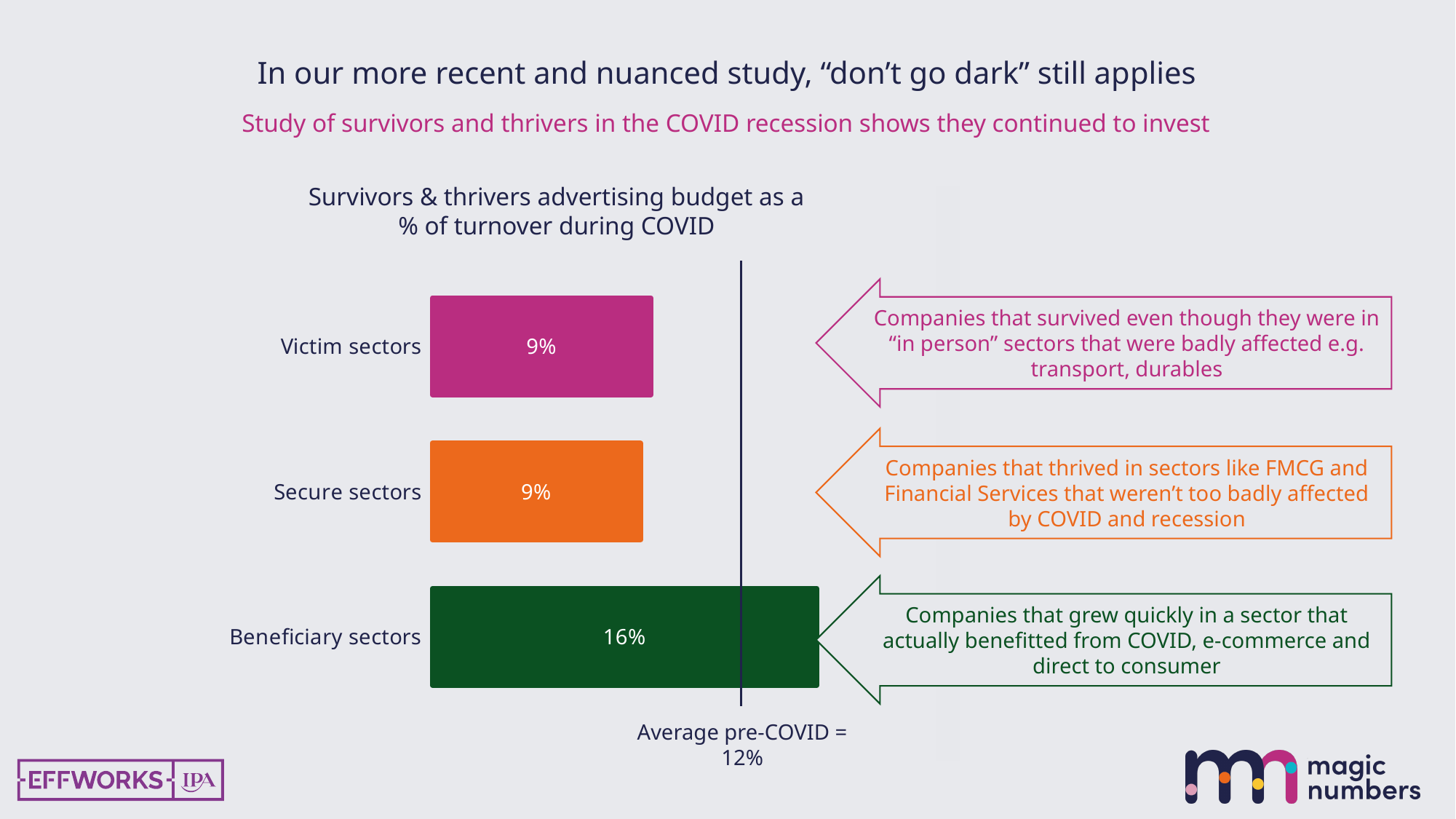
What is the title of the chart? Survivors & thrivers advertising budget as a % of turnover during COVID What is the advertising budget as a % of turnover for Victim sectors? 9% What colour is the bar for Beneficiary sectors? Green What is the average pre-COVID value marked by the vertical line on the chart? 12% What is the advertising budget as a % of turnover for Secure sectors? 9% What kind of chart is shown on the slide? Bar chart How many sector categories are shown in the chart? 3 Which is larger, the value for Beneficiary sectors or the value for Secure sectors? Beneficiary sectors Which sector category has the highest advertising budget as a % of turnover? Beneficiary sectors What is the advertising budget as a % of turnover for Beneficiary sectors? 16% What is the difference between the Beneficiary sectors value and the Victim sectors value? 7% Is the value for Beneficiary sectors greater or less than the pre-COVID average of 12%? greater